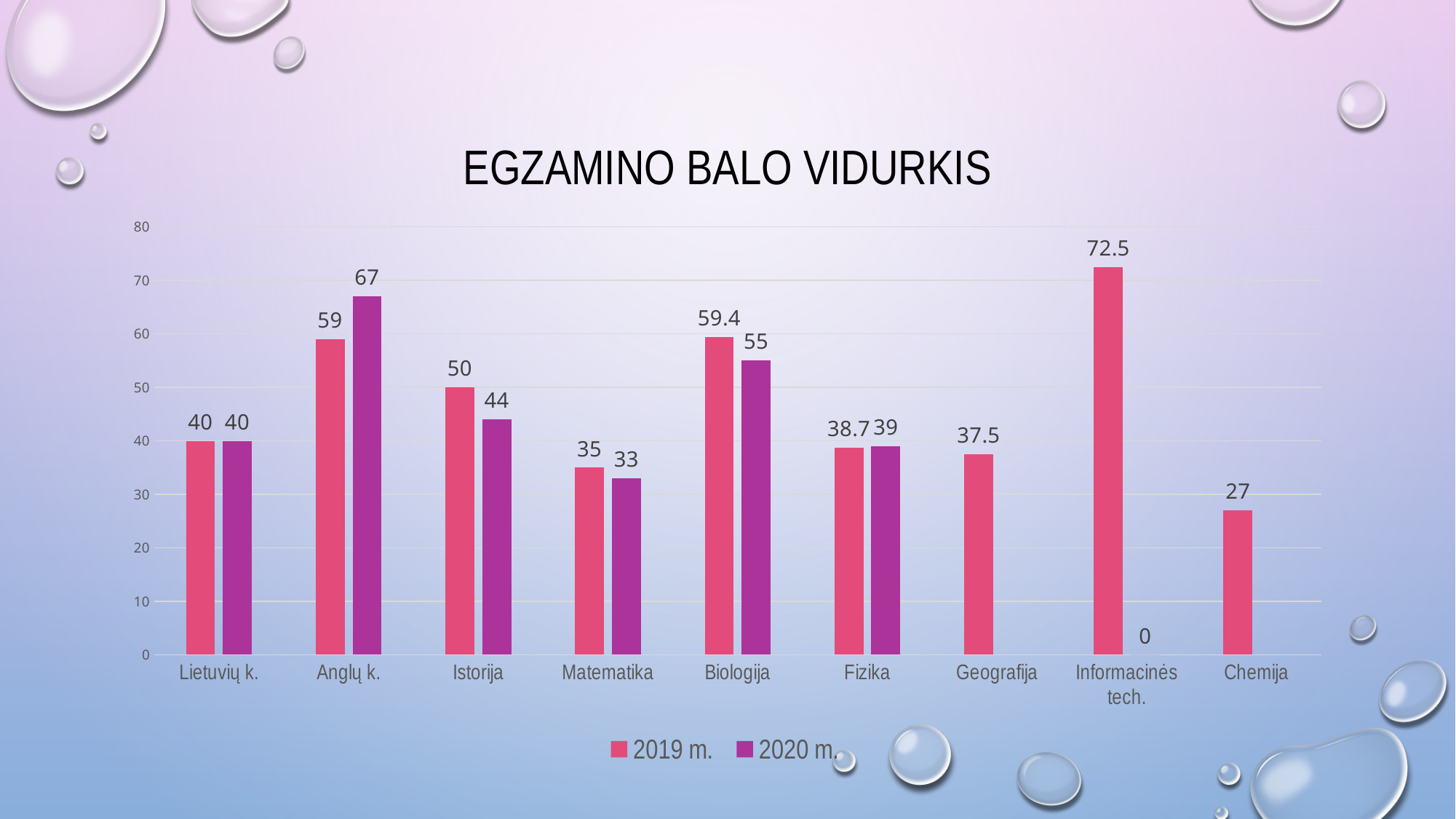
What kind of chart is shown on the slide? Bar chart How many series does the legend list? 2 What is the 2019 m. value for Biologija? 59.4 What is the title of the chart? EGZAMINO BALO VIDURKIS Which is larger for Anglų k., the 2019 m. value or the 2020 m. value? 2020 m. What is the difference between the 2019 m. and 2020 m. values for Istorija? 6 Which category has the highest 2019 m. value? Informacinės tech. How many categories are shown on the x axis? 9 What is the 2019 m. value for Informacinės tech.? 72.5 Which category has the lowest 2019 m. value? Chemija Which category has the highest 2020 m. value? Anglų k. What is the 2020 m. value for Anglų k.? 67